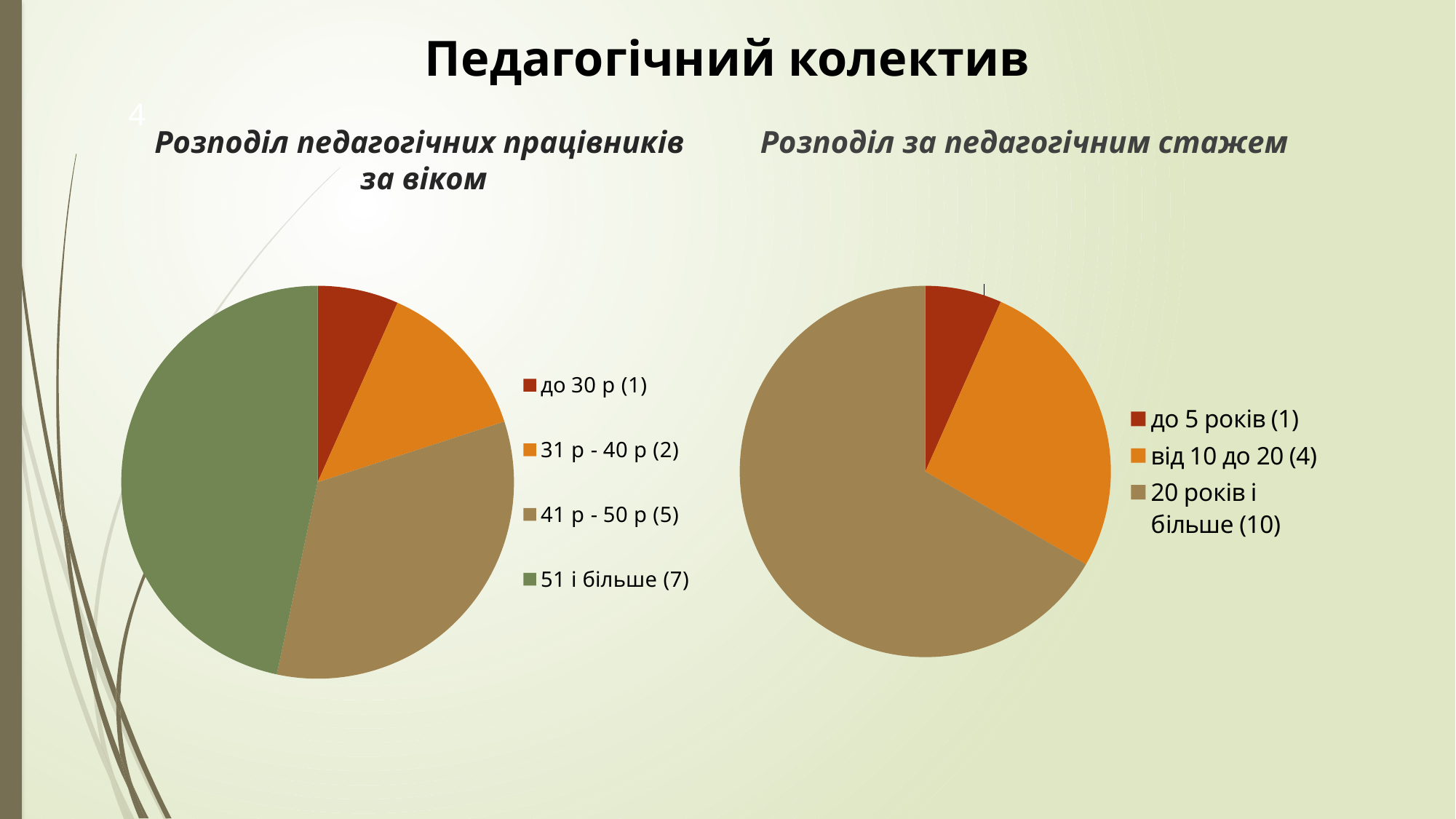
In the chart "Розподіл педагогічних працівників за віком", what colour is the "51 і більше" slice? green In the chart "Розподіл педагогічних працівників за віком", which age category has the most teachers? 51 і більше In the chart "Розподіл педагогічних працівників за віком", what is the difference between the "51 і більше" and "31 р - 40 р" counts? 5 In the chart "Розподіл педагогічних працівників за віком", how many teachers are in the "41 р - 50 р" category? 5 In the chart "Розподіл за педагогічним стажем", how many categories are shown? 3 In the chart "Розподіл педагогічних працівників за віком", how many categories does the legend list? 4 What type of chart is used for "Розподіл педагогічних працівників за віком"? pie chart In the chart "Розподіл за педагогічним стажем", which category is the largest? 20 років і більше In the chart "Розподіл за педагогічним стажем", how many teachers have "від 10 до 20" years of experience? 4 In the chart "Розподіл педагогічних працівників за віком", which age category has the fewest teachers? до 30 р In the chart "Розподіл за педагогічним стажем", what is the difference between "20 років і більше" and "до 5 років"? 9 In the chart "Розподіл за педагогічним стажем", which is larger: "до 5 років" or "від 10 до 20"? від 10 до 20